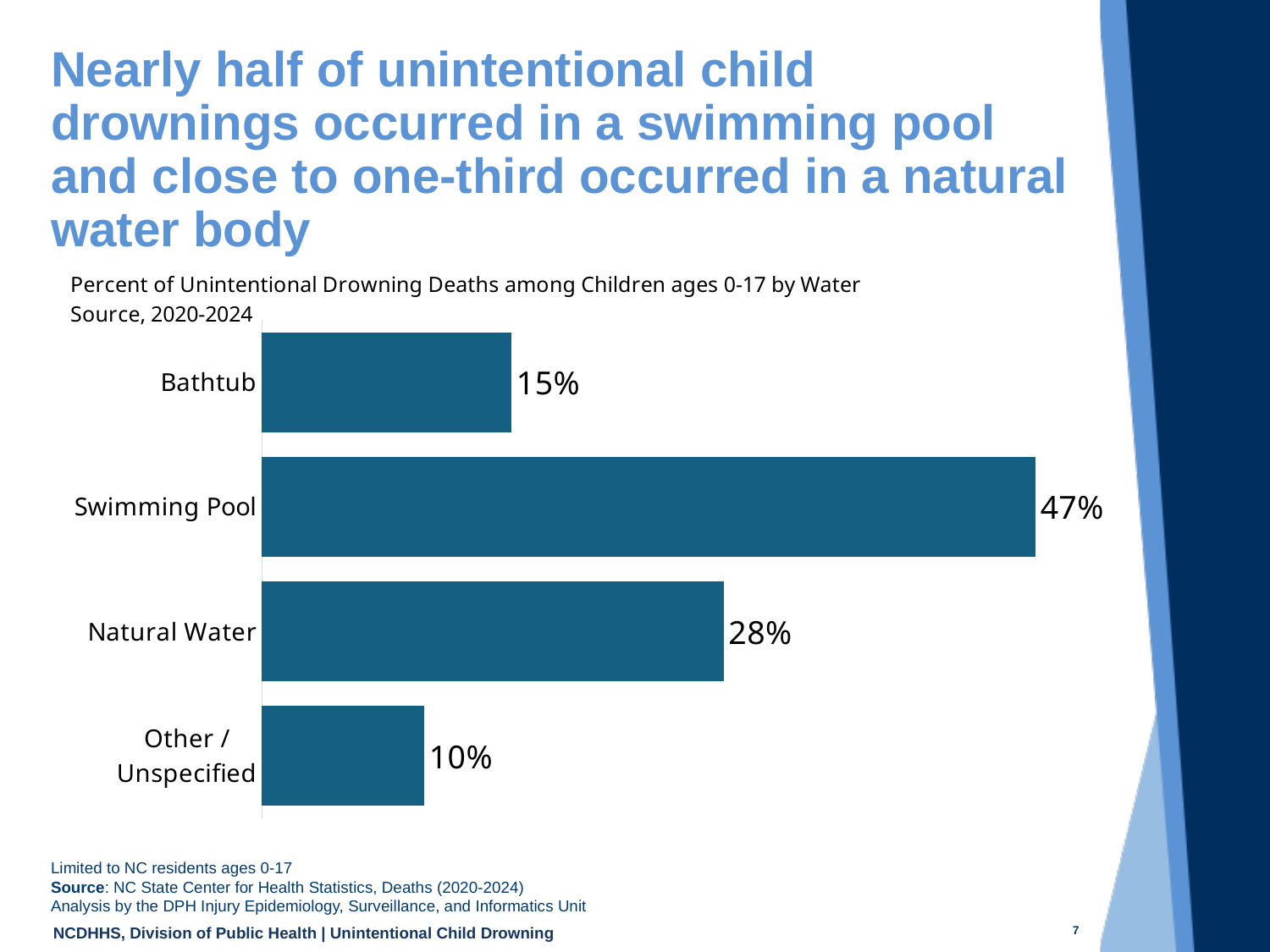
Which is larger, the value for Bathtub or the value for Natural Water? Natural Water What percent of unintentional drowning deaths among children occurred in a swimming pool? 47% Which water source has the lowest percent of unintentional drowning deaths? Other / Unspecified What is the value shown for Other / Unspecified? 10% What kind of chart is shown on the slide? Bar chart How many water source categories are shown in the chart? 4 What is the value shown for Bathtub? 15% What is the difference in percentage points between Bathtub and Other / Unspecified? 5 What percent of unintentional drowning deaths among children occurred in natural water? 28% Which water source has the highest percent of unintentional drowning deaths? Swimming Pool What is the difference in percentage points between Swimming Pool and Natural Water? 19 What is the title of the chart? Percent of Unintentional Drowning Deaths among Children ages 0-17 by Water Source, 2020-2024